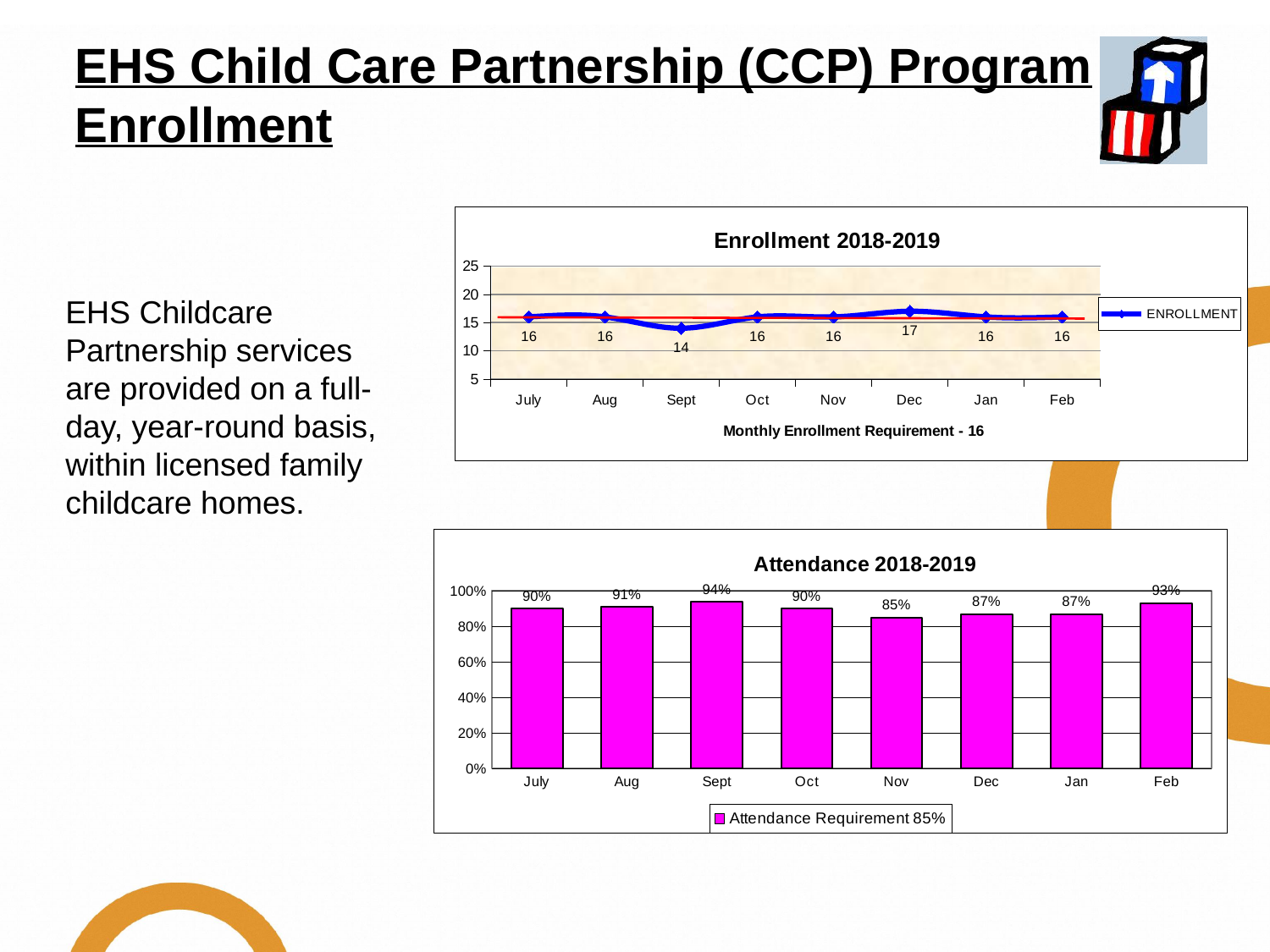
In the Enrollment 2018-2019 chart, which month has the highest enrollment? Dec In the Attendance 2018-2019 chart, which month has the lowest attendance? Nov What kind of chart is the Enrollment 2018-2019 chart? Line chart In the Enrollment 2018-2019 chart, what is the difference between the Dec and Sept enrollment values? 3 In the Enrollment 2018-2019 chart, how many months are plotted? 8 In the Attendance 2018-2019 chart, which month has the highest attendance? Sept What kind of chart is the Attendance 2018-2019 chart? Bar chart In the Enrollment 2018-2019 chart, which month has the lowest enrollment? Sept In the Enrollment 2018-2019 chart, what is the enrollment value for Sept? 14 In the Attendance 2018-2019 chart, what is the attendance value for Nov? 85% In the Attendance 2018-2019 chart, what is the difference between the Feb and Oct attendance values? 3% In the Attendance 2018-2019 chart, is the attendance for Aug higher or lower than for Jan? Higher